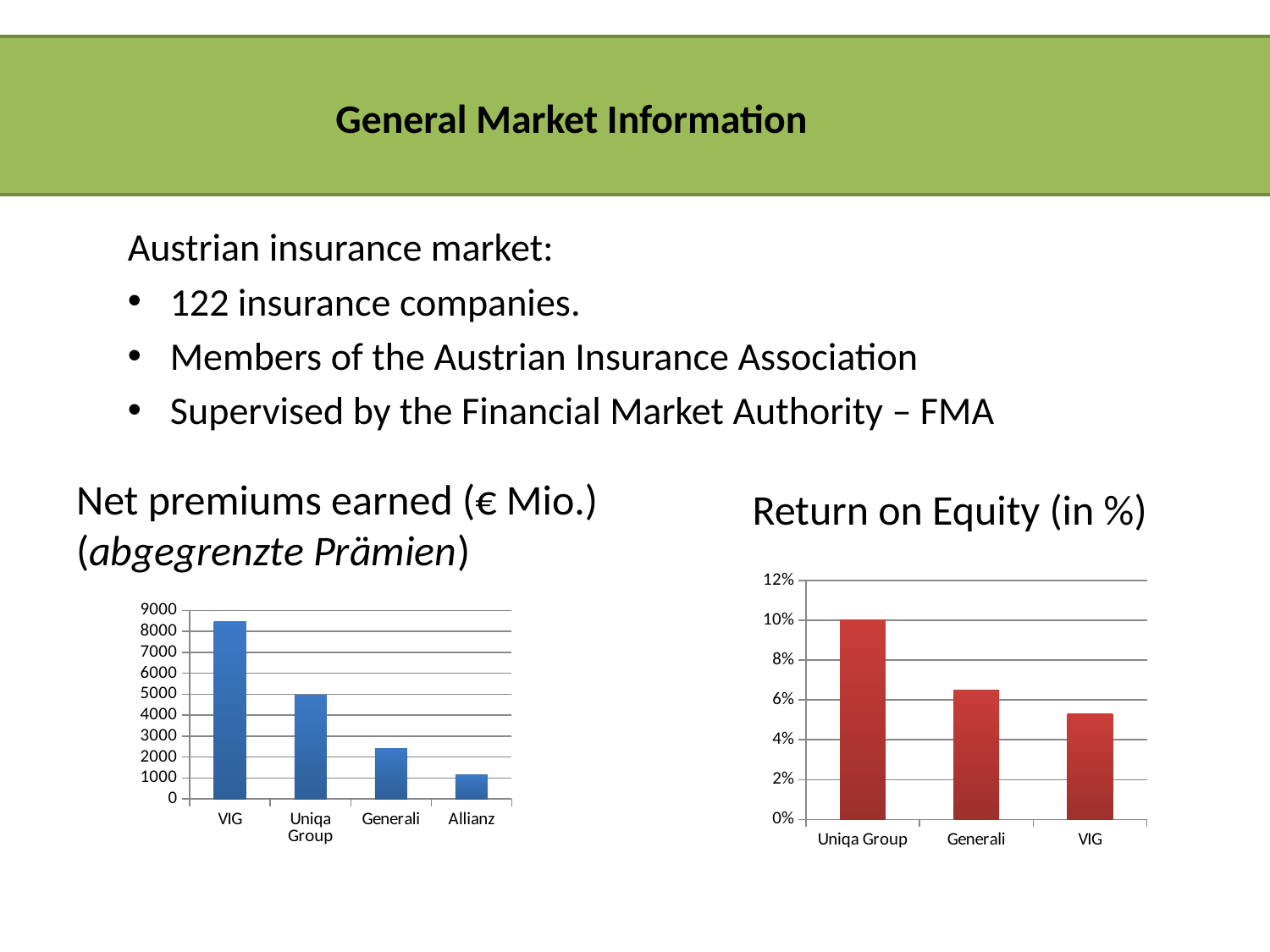
In the Net premiums earned chart, which company has the lowest value? Allianz In the Net premiums earned chart, is the value for Uniqa Group greater or less than 4000? greater In the Net premiums earned chart, is the value for Generali greater or less than 3000? less In the Return on Equity chart, which company has the lowest value? VIG In the Net premiums earned chart, which company has the highest value? VIG In the Return on Equity chart, is the value for Generali greater or less than 8%? less In the Return on Equity chart, which company has the highest value? Uniqa Group What kind of chart is the Return on Equity chart? bar chart How many companies are shown in the Net premiums earned chart? 4 In the Net premiums earned chart, which is larger, Uniqa Group or Generali? Uniqa Group How many companies are shown in the Return on Equity chart? 3